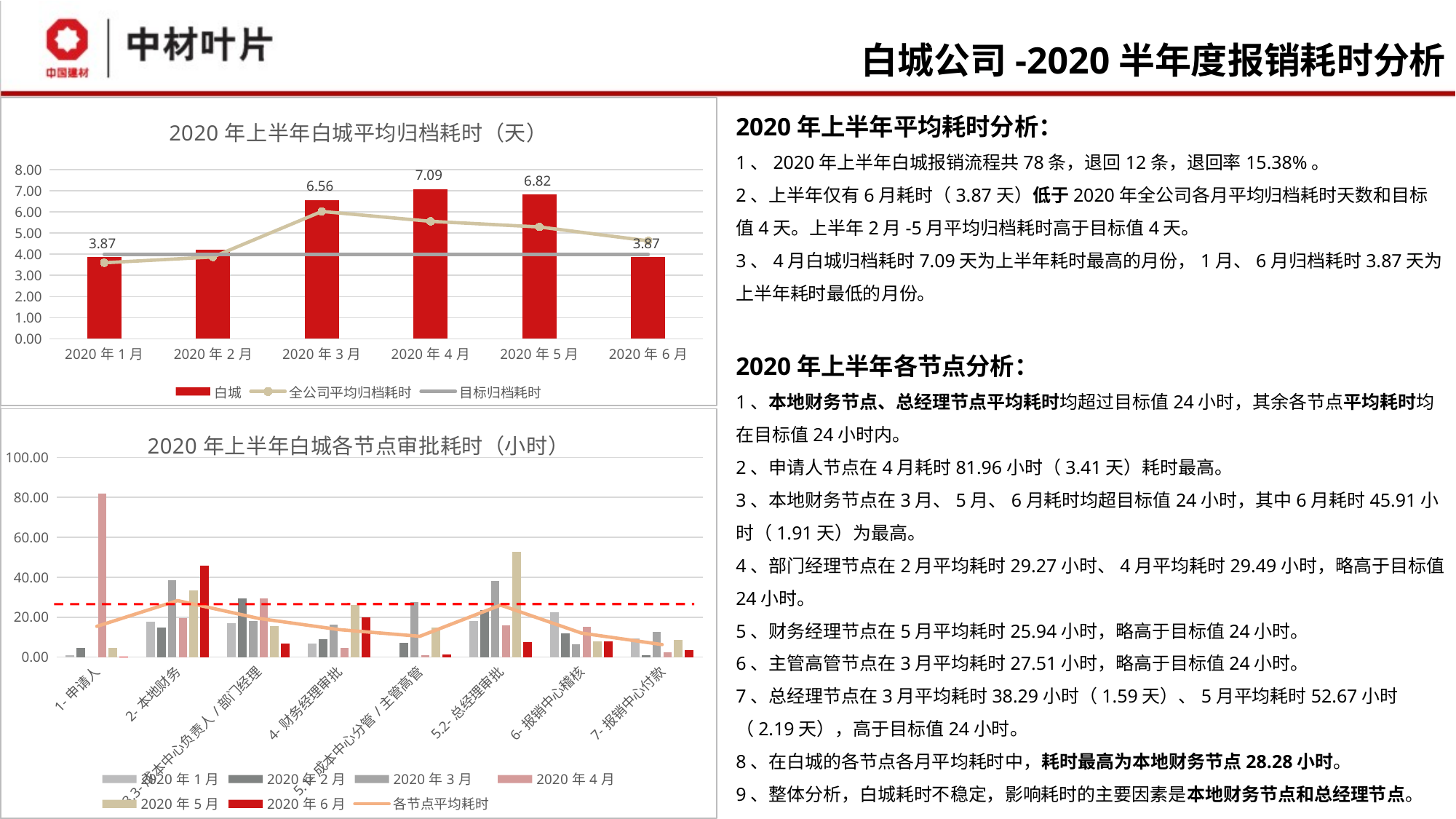
In the bottom chart (2020年上半年白城各节点审批耗时), how many node categories are shown on the x axis? 8 In the top chart (2020年上半年白城平均归档耗时), what is the 白城 value for 2020年4月? 7.09 In the top chart (2020年上半年白城平均归档耗时), what is the difference between the 白城 values for 2020年4月 and 2020年3月? 0.53 In the top chart (2020年上半年白城平均归档耗时), is the 白城 value for 2020年2月 greater or less than 5.00? less What kind of chart is the top chart titled 2020年上半年白城平均归档耗时（天）? A bar chart with line series In the bottom chart (2020年上半年白城各节点审批耗时), is the 2020年4月 value for 1-申请人 greater or less than 60.00? greater In the bottom chart (2020年上半年白城各节点审批耗时), how many entries does the legend list? 7 In the top chart (2020年上半年白城平均归档耗时), which is larger, the 白城 value for 2020年3月 or for 2020年5月? 2020年5月 In the top chart (2020年上半年白城平均归档耗时), which month has the highest 白城 bar? 2020年4月 In the top chart (2020年上半年白城平均归档耗时), how many months are shown on the x axis? 6 In the top chart (2020年上半年白城平均归档耗时), how many series does the legend list? 3 In the top chart (2020年上半年白城平均归档耗时), what is the 白城 value for 2020年6月? 3.87